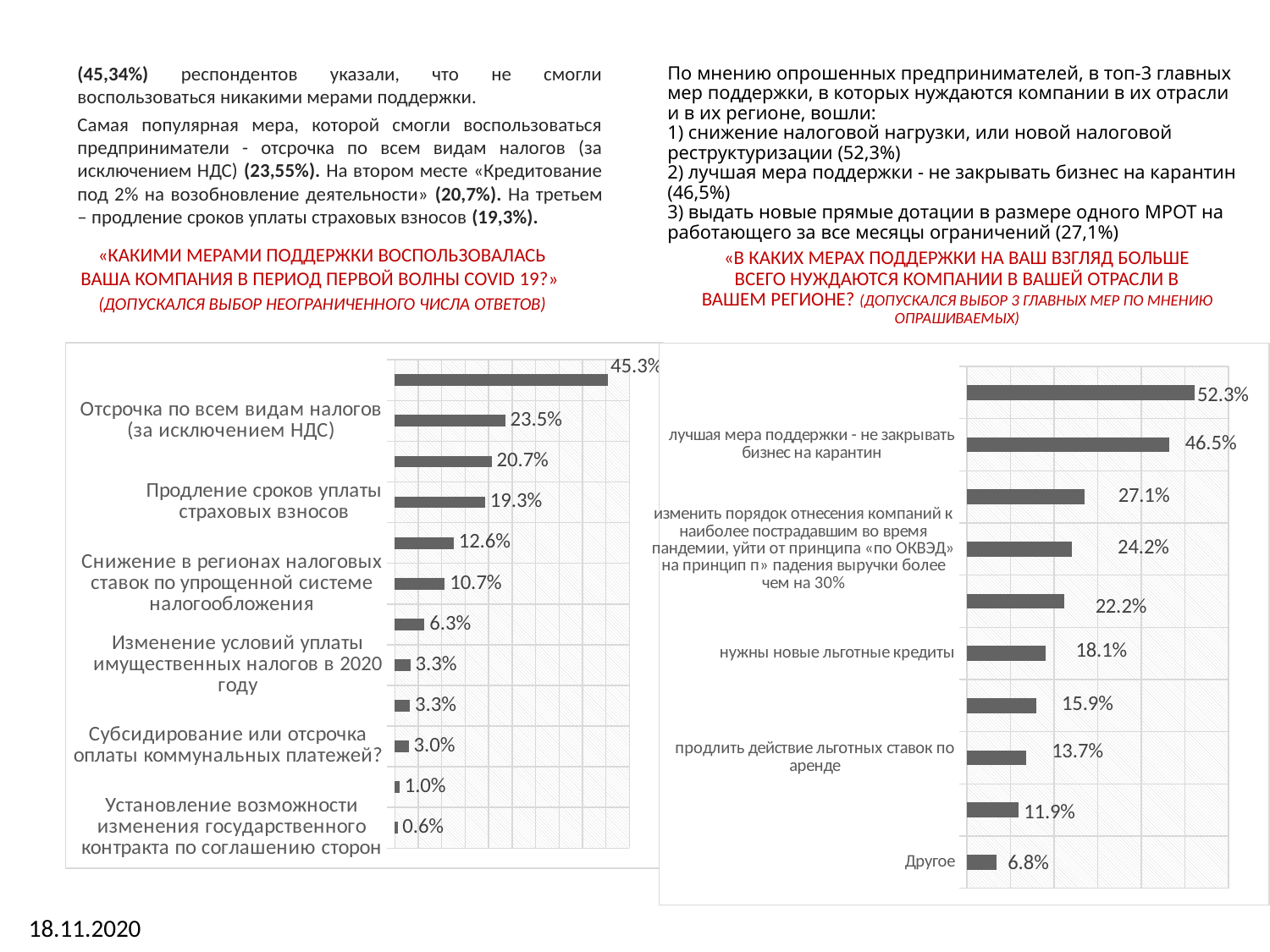
In the left chart, what is the highest value shown? 45.3% What type of chart is shown on the left side of the slide? Bar chart In the right chart, which category has the lowest value? Другое In the left chart, what is the value for «Отсрочка по всем видам налогов (за исключением НДС)»? 23.5% In the right chart, what is the difference between the top value 52.3% and the value for «лучшая мера поддержки - не закрывать бизнес на карантин»? 5.8% In the left chart, what is the lowest value shown? 0.6% How many bars are plotted in the right chart? 10 In the right chart, what is the highest value shown? 52.3% In the right chart, what is the value for «лучшая мера поддержки - не закрывать бизнес на карантин»? 46.5% How many bars are plotted in the left chart? 12 In the left chart, what is the value for «Продление сроков уплаты страховых взносов»? 19.3% In the right chart, what is the value for «Другое»? 6.8%